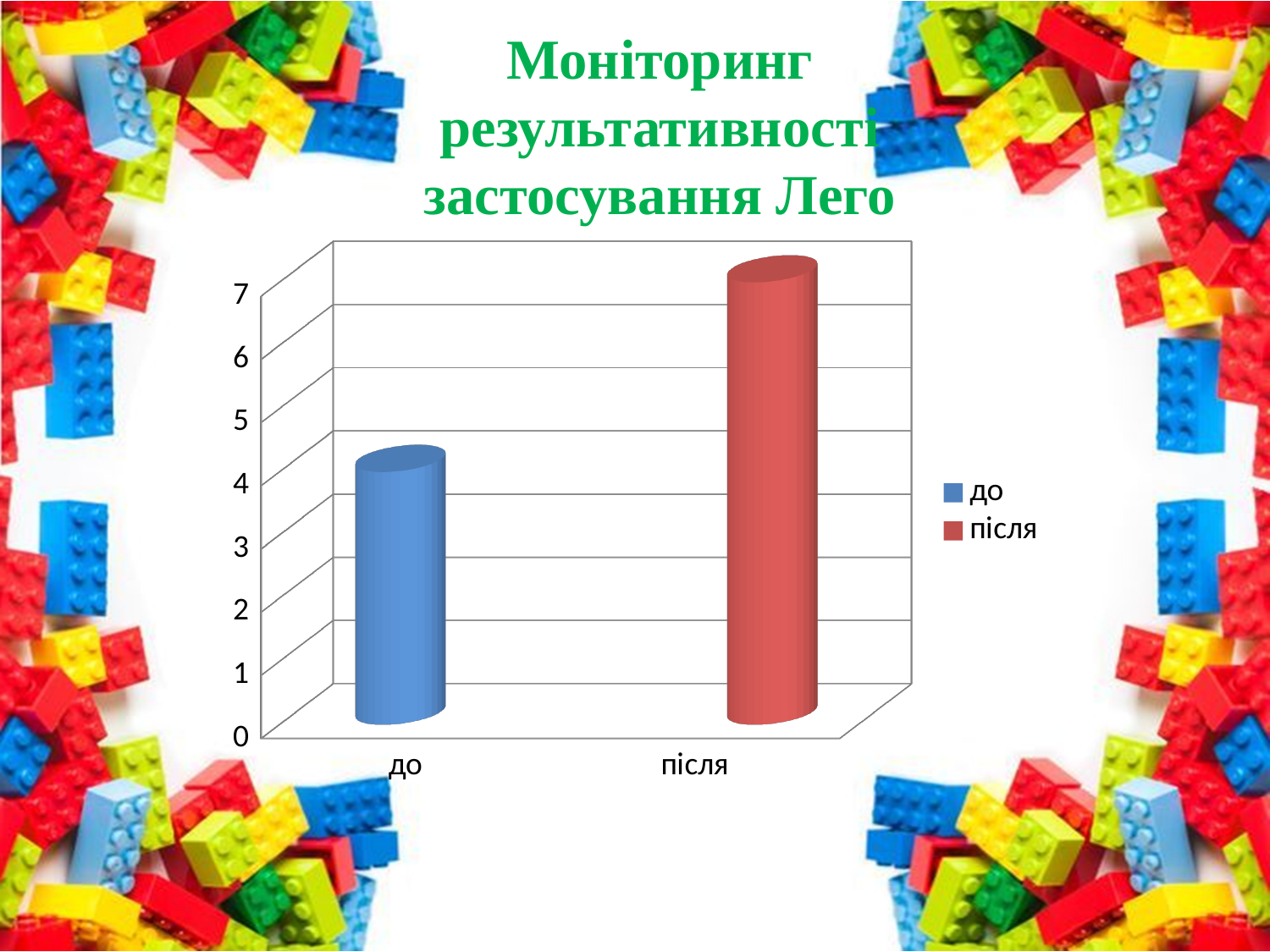
How many entries does the chart's legend list? 2 Do the values rise or fall from "до" to "після"? rise How many categories are shown on the x axis of the chart? 2 Which category has the highest bar in the chart? після Which category has the lowest bar in the chart? до What colour is the bar for "після" in the chart? red Is the value for "до" greater or less than 3? greater Is the value for "після" greater or less than 6? greater Which bar is taller, "до" or "після"? після Is the value for "до" greater or less than 5? less What kind of chart is shown on the slide? bar chart What is the title of the slide containing the chart? Моніторинг результативності застосування Лего